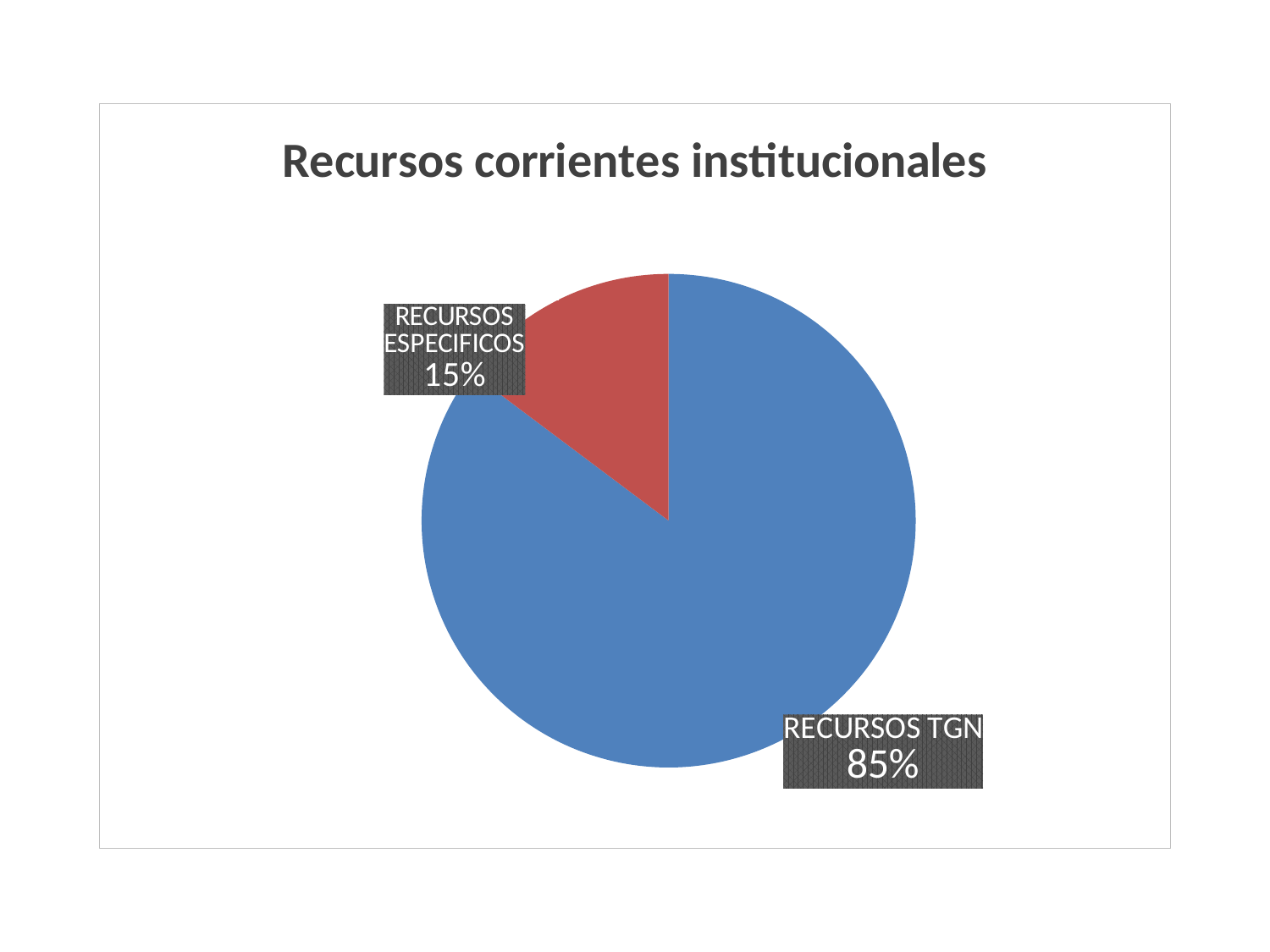
What is the difference in percentage points between RECURSOS TGN and RECURSOS ESPECIFICOS? 70 Is the share for RECURSOS TGN greater or less than 50%? greater What type of chart is shown on the slide? pie chart What colour is the RECURSOS ESPECIFICOS slice? red Which is larger, RECURSOS TGN or RECURSOS ESPECIFICOS? RECURSOS TGN What is the title of the chart? Recursos corrientes institucionales What share of the pie does RECURSOS ESPECIFICOS represent? 15% How many slices does the pie chart have? 2 Which slice is the largest in the pie chart? RECURSOS TGN Which slice is the smallest in the pie chart? RECURSOS ESPECIFICOS What share of the pie does RECURSOS TGN represent? 85%